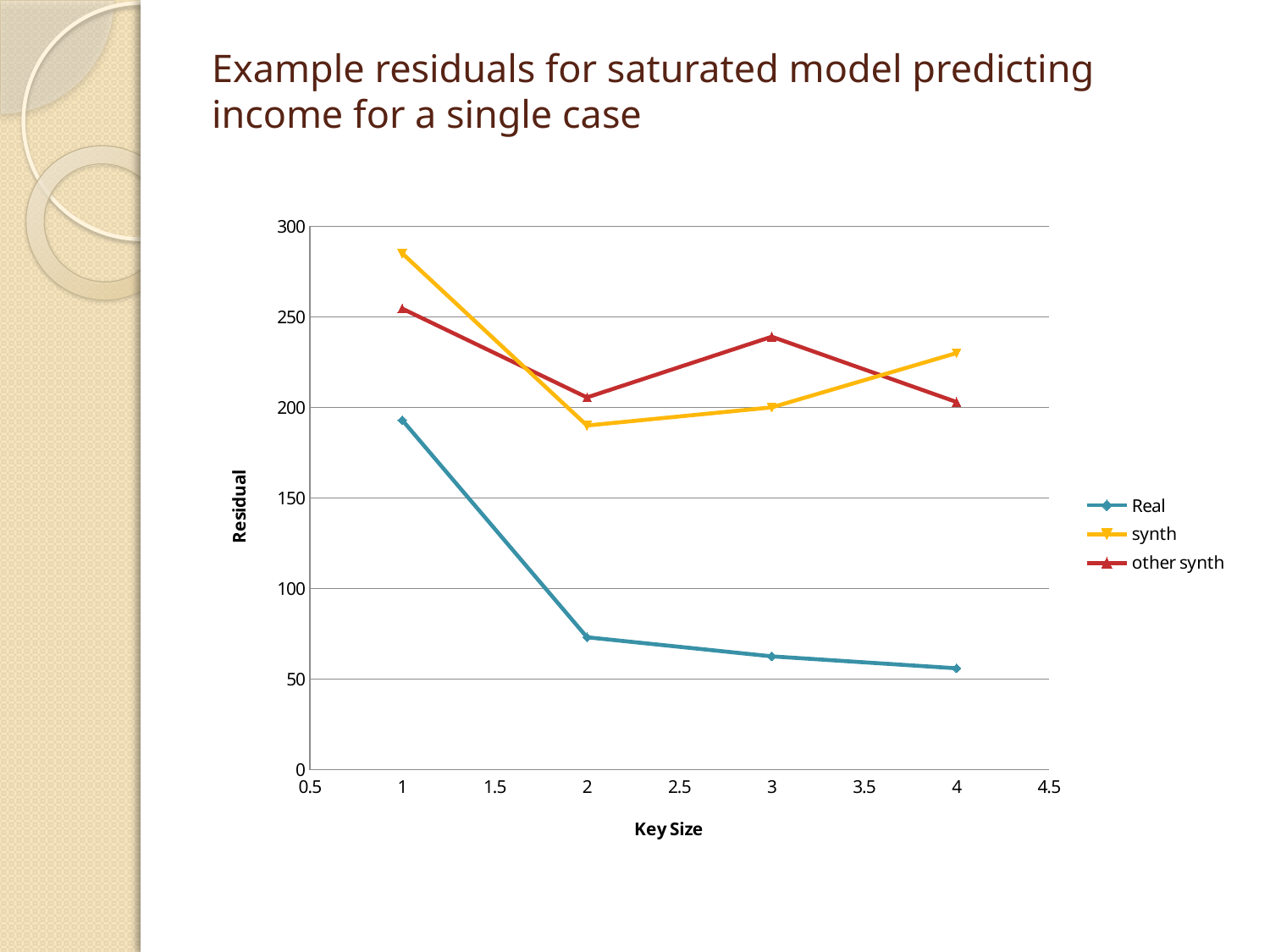
Is the synth residual at Key Size 2 greater or less than 200? less Does the Real series rise or fall as Key Size increases from 1 to 4? fall Which series has the lowest residual at Key Size 2? Real How many series does the legend list? 3 Is the Real residual at Key Size 4 greater or less than 100? less Is the synth residual at Key Size 1 greater or less than 250? greater At Key Size 3, which has the larger residual, synth or other synth? other synth What is the title of the x axis? Key Size What kind of chart is shown on the slide? line chart How many key sizes are plotted for each series? 4 Which series has the highest residual at Key Size 1? synth